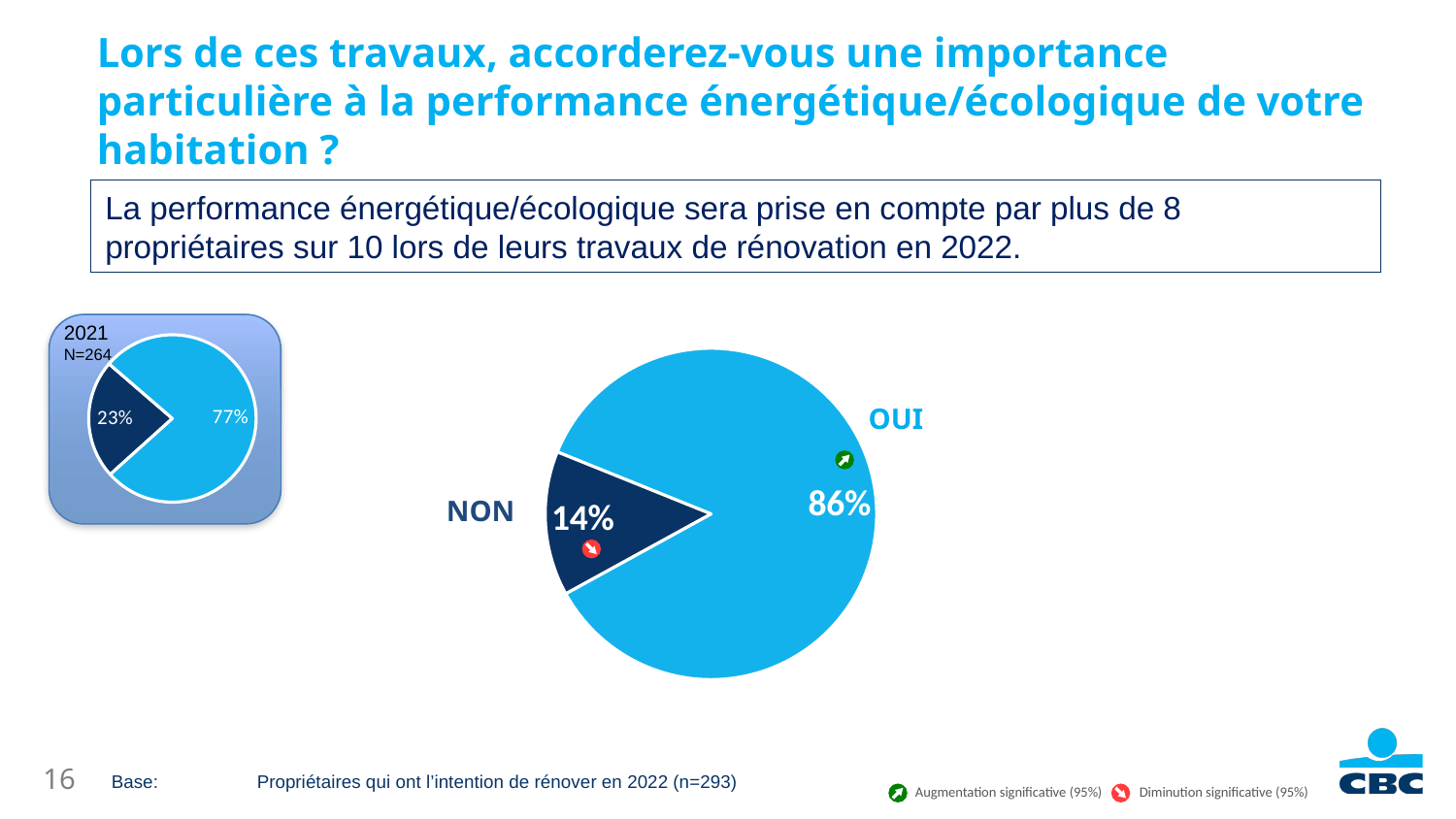
In the large pie chart, what percentage is shown for OUI? 86% In the large pie chart, which is larger, OUI or NON? OUI What sample size (N) is shown for the small 2021 pie chart on the left? N=264 In the small 2021 pie chart on the left, what percentage is shown for the dark blue slice? 23% In the large pie chart, which slice is the smallest? NON In the large pie chart, which slice is the largest? OUI What type of chart is the large chart in the centre of the slide? Pie chart How many slices does the large pie chart have? 2 In the large pie chart, what colour is the OUI slice? Light blue In the large pie chart, what is the difference in percentage points between OUI and NON? 72 In the large pie chart, what percentage is shown for NON? 14% In the small 2021 pie chart on the left, what percentage is shown for the light blue slice? 77%